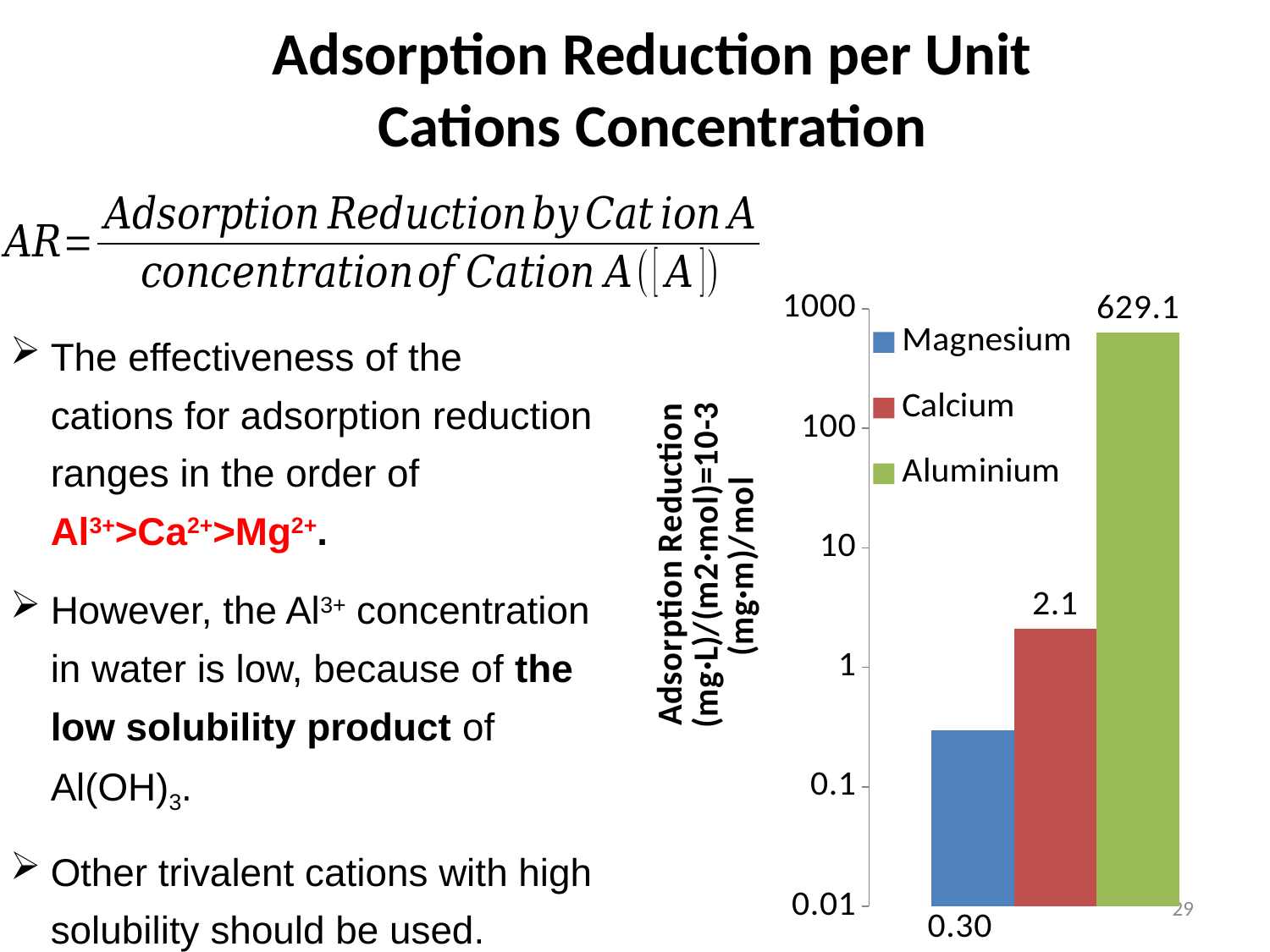
Is the value for Magnesium greater or less than 1? less Which cation has the highest adsorption reduction value? Aluminium What colour is the Aluminium bar in the chart? Green Which has a larger adsorption reduction value, Calcium or Magnesium? Calcium What is the difference between the adsorption reduction values for Aluminium and Calcium? 627.0 What is the adsorption reduction value for Calcium? 2.1 Is the value for Aluminium greater or less than 100? greater Which cation has the lowest adsorption reduction value? Magnesium How many series does the legend list? 3 What kind of chart is shown on the slide? Bar chart What is the adsorption reduction value for Aluminium? 629.1 What is the adsorption reduction value for Magnesium? 0.30